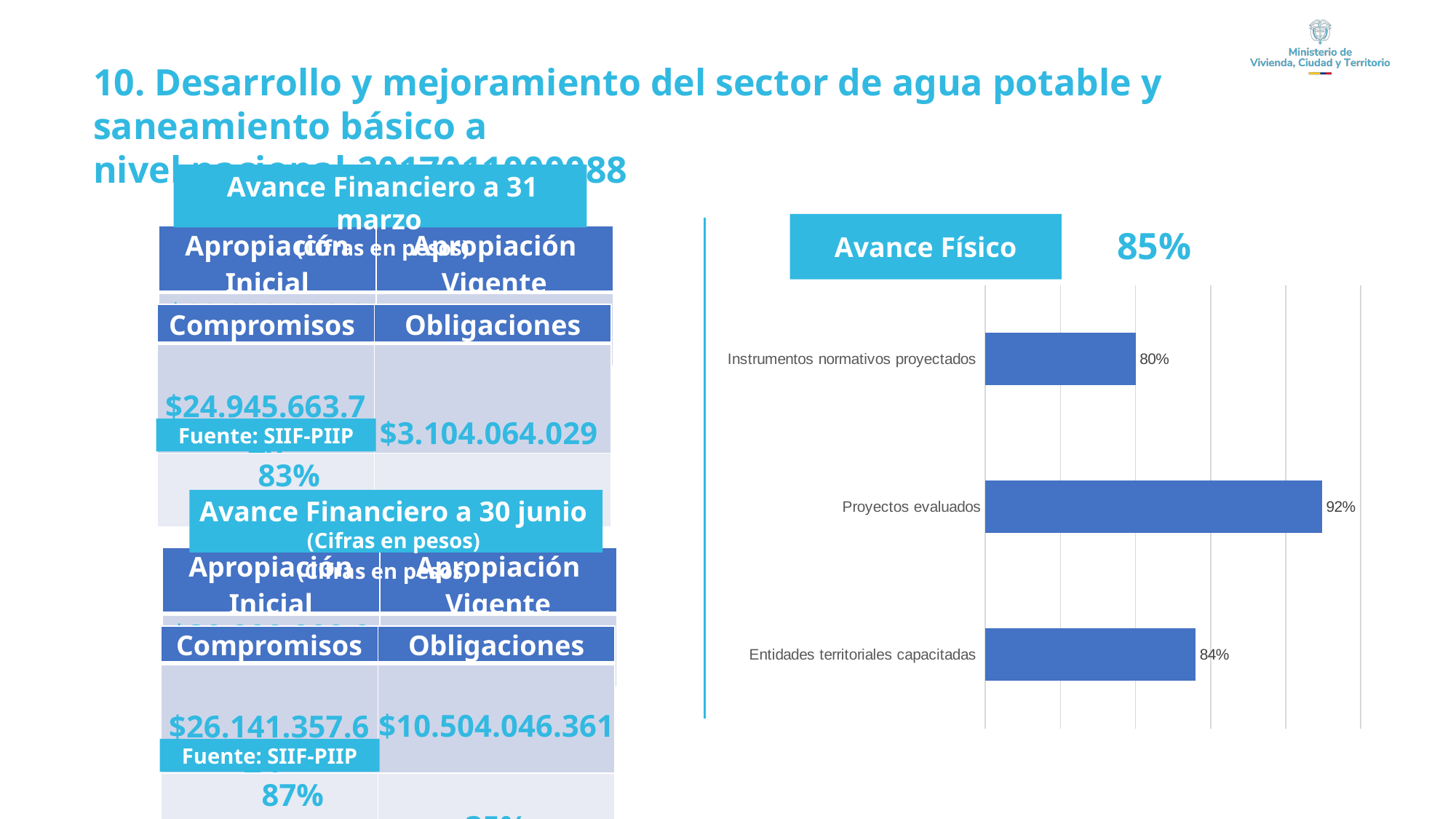
Which category has the highest value in the bar chart? Proyectos evaluados What is the heading shown above the bar chart? Avance Físico How many categories are shown in the bar chart? 3 What value is shown for Entidades territoriales capacitadas in the bar chart? 84% What is the difference between the values for Proyectos evaluados and Instrumentos normativos proyectados? 12% What value is shown for Instrumentos normativos proyectados in the bar chart? 80% Which category has the lowest value in the bar chart? Instrumentos normativos proyectados Which is larger in the bar chart: Entidades territoriales capacitadas or Proyectos evaluados? Proyectos evaluados Which is larger in the bar chart: Instrumentos normativos proyectados or Entidades territoriales capacitadas? Entidades territoriales capacitadas What type of chart is shown on the right side of the slide? Bar chart What is the difference between the values for Entidades territoriales capacitadas and Instrumentos normativos proyectados? 4% What value is shown for Proyectos evaluados in the bar chart? 92%